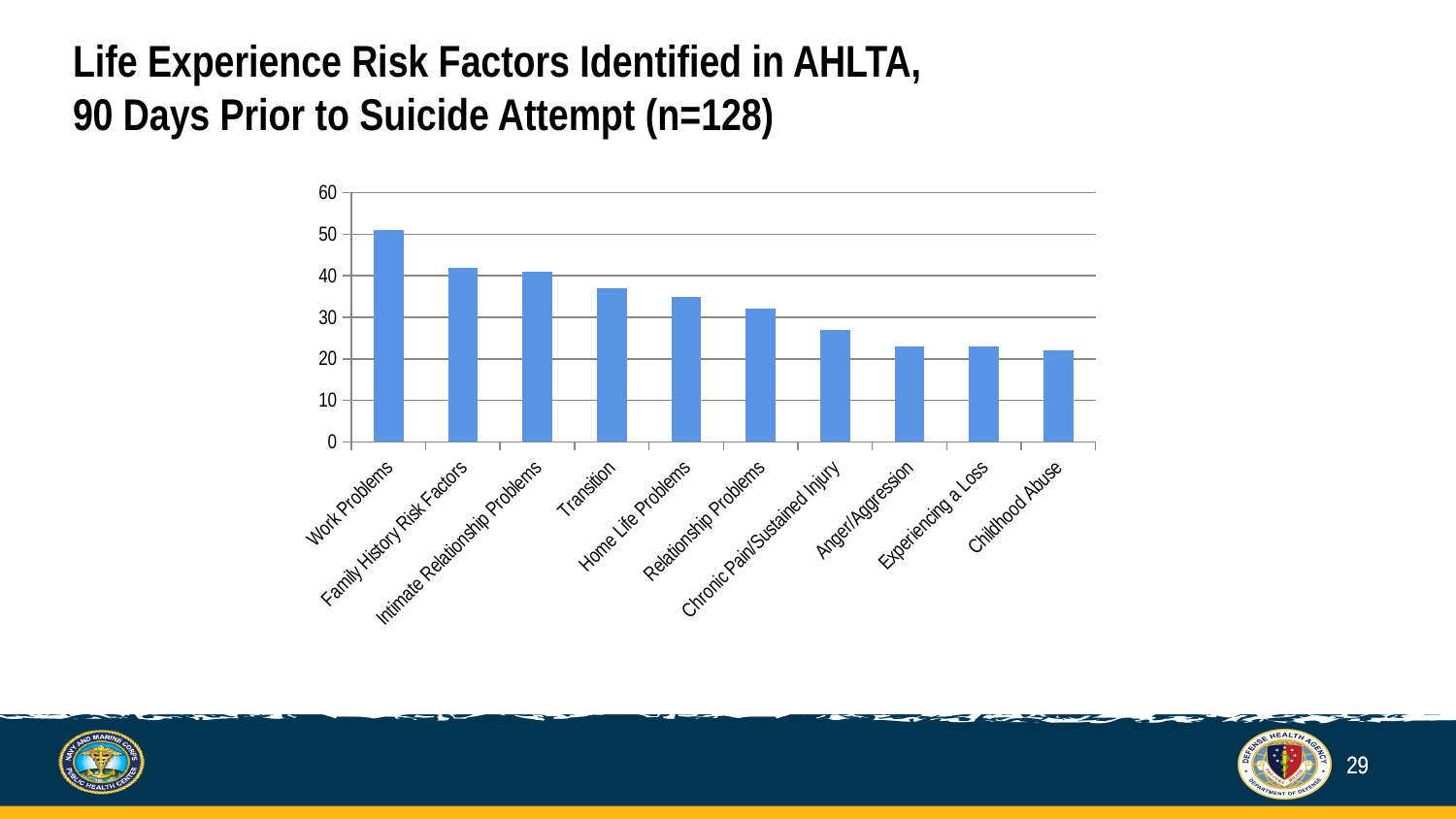
Is the value for Work Problems greater or less than 40? greater Do the values rise or fall moving from left to right along the x axis? fall Is the value for Home Life Problems greater or less than 30? greater Is the value for Transition greater or less than 40? less Which is larger, the value for Family History Risk Factors or the value for Chronic Pain/Sustained Injury? Family History Risk Factors Which risk factor has the highest value on the chart? Work Problems What kind of chart is shown on the slide? bar chart How many risk factor categories are plotted on the chart? 10 What is the sample size (n) stated in the slide title? 128 Which is larger, the value for Work Problems or the value for Transition? Work Problems